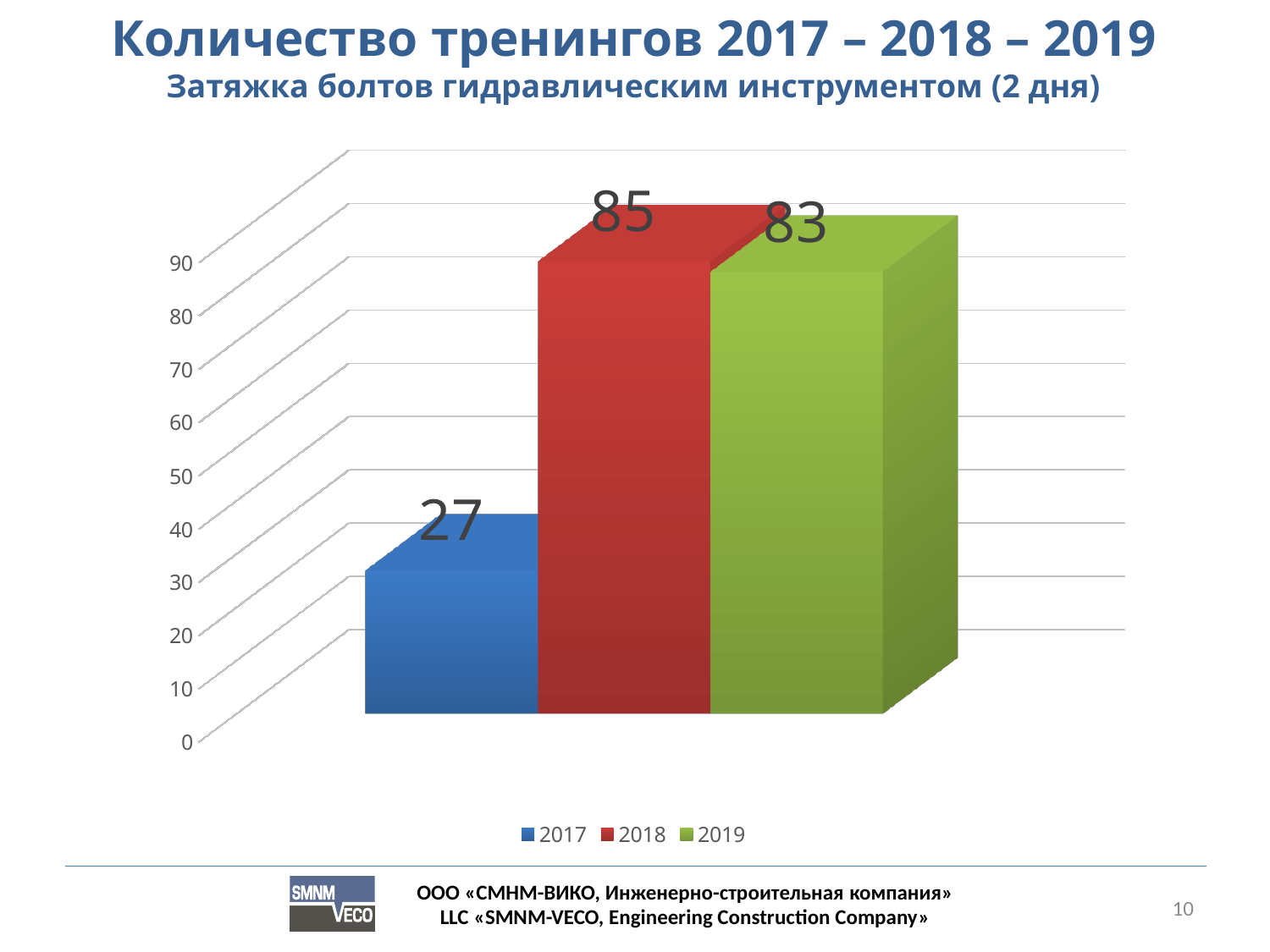
What is the difference between the values for 2018 and 2017? 58 What kind of chart is shown on the slide? bar chart What is the subtitle of the chart below the main title? Затяжка болтов гидравлическим инструментом (2 дня) What is the value for 2018? 85 How many series does the legend list? 3 What is the difference between the values for 2018 and 2019? 2 What colour is the bar for 2018? red Which year has the highest value? 2018 Which year has the lowest value? 2017 Which is larger, the value for 2017 or the value for 2019? 2019 What is the value for 2017? 27 What is the value for 2019? 83